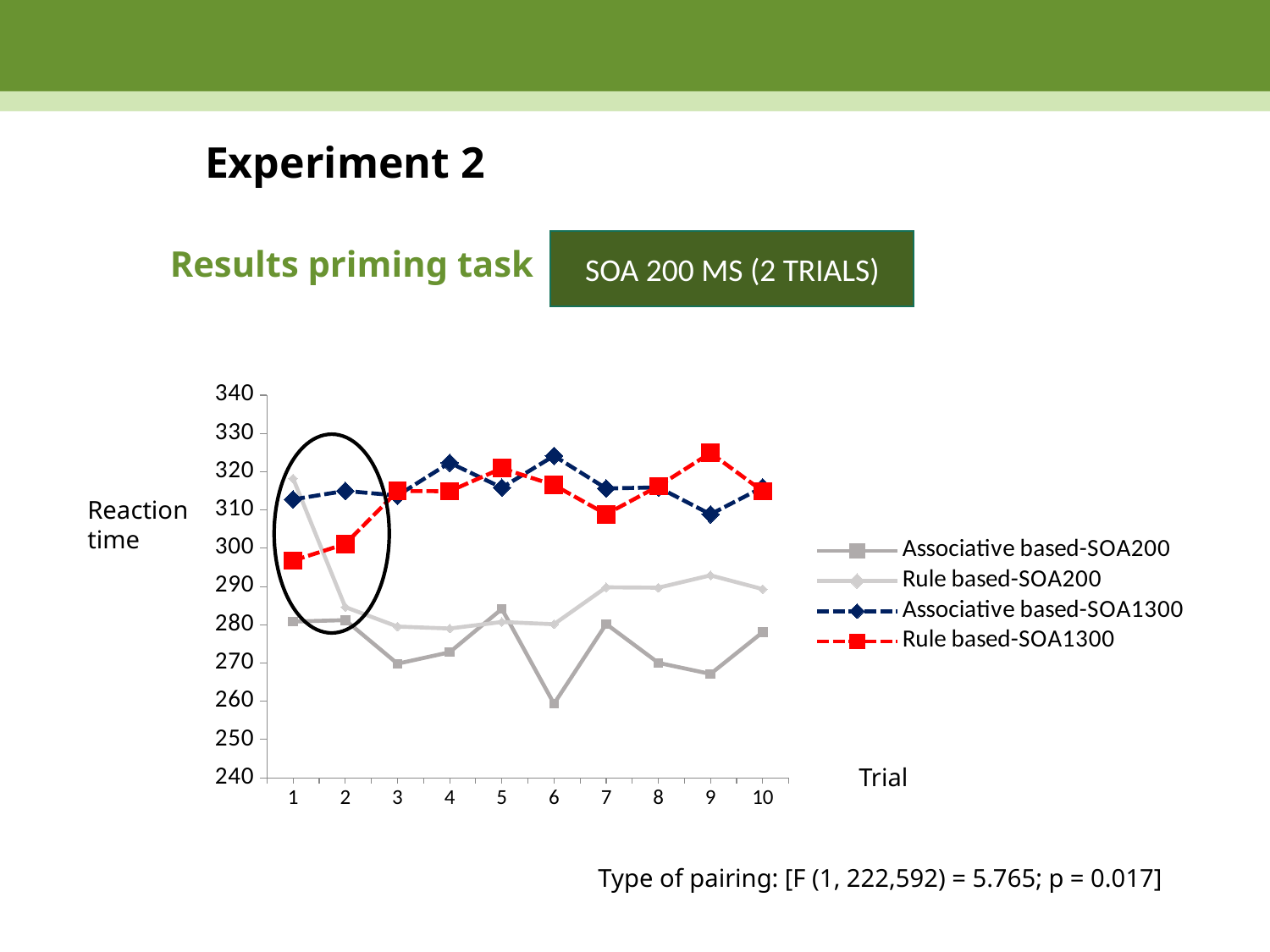
Which trial has the highest value for the Rule based-SOA200 series? 1 What is the label on the y axis of the chart? Reaction time Which trial has the highest value for the Rule based-SOA1300 series? 9 At trial 1, which is larger: Associative based-SOA1300 or Rule based-SOA1300? Associative based-SOA1300 Does the Rule based-SOA200 series rise or fall from trial 1 to trial 2? fall What kind of chart is shown on the slide? line chart Is the value for Rule based-SOA1300 at trial 1 greater or less than 300? less How many trials are plotted along the x axis? 10 Is the value for Associative based-SOA1300 at trial 6 greater or less than 320? greater How many series does the legend list? 4 Which trial has the lowest value for the Associative based-SOA200 series? 6 Is the value for Associative based-SOA200 at trial 6 greater or less than 270? less